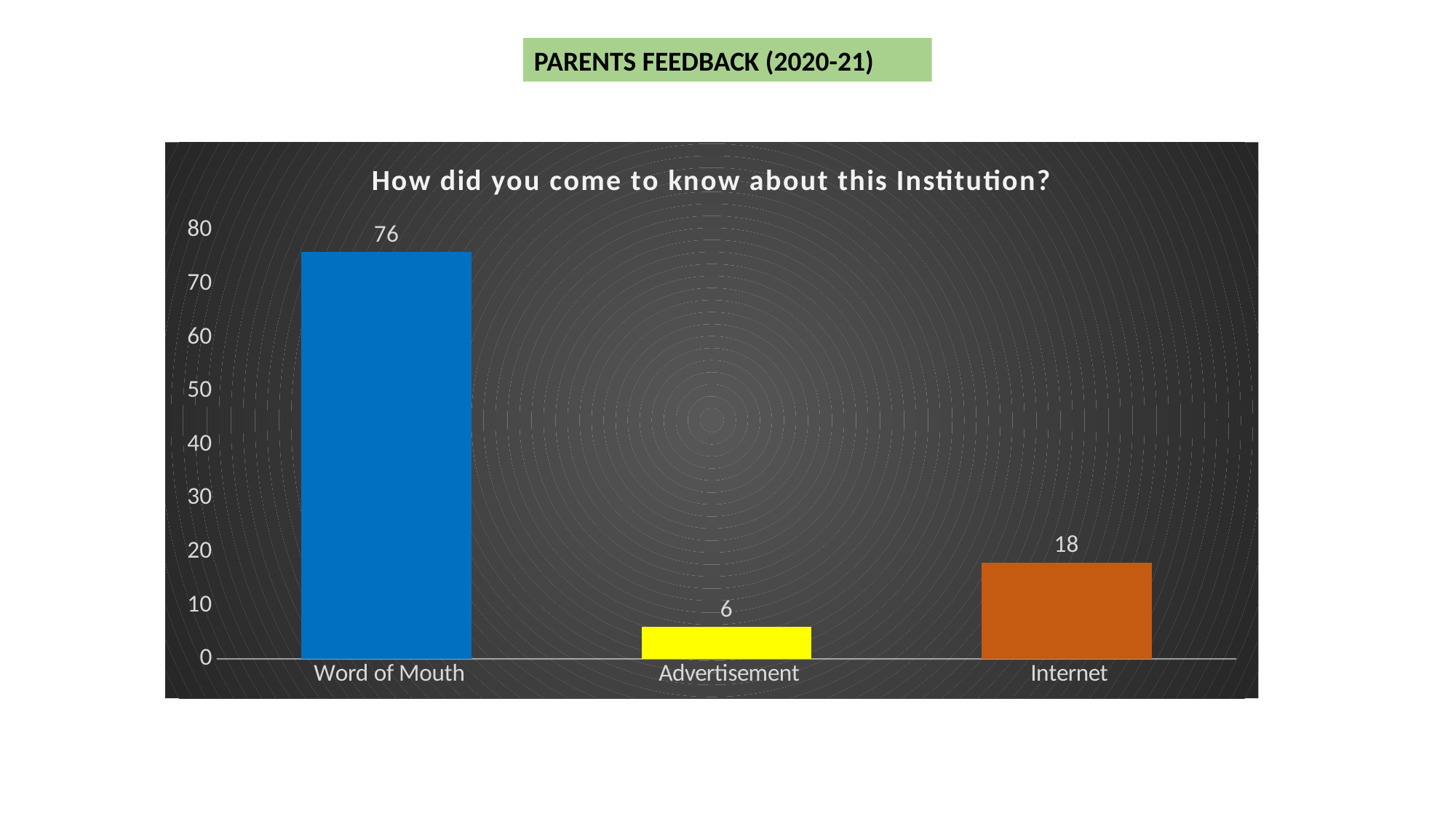
What kind of chart is shown on the slide? bar chart What is the difference between the values for Internet and Advertisement? 12 What is the value for Advertisement? 6 What is the title of the chart? How did you come to know about this Institution? Which is larger, the value for Internet or the value for Advertisement? Internet What is the value for Word of Mouth? 76 What is the difference between the values for Word of Mouth and Internet? 58 Is the value for Word of Mouth greater or less than 70? greater Which category has the lowest value? Advertisement Which category has the highest value? Word of Mouth What is the value for Internet? 18 How many categories are shown on the x axis? 3